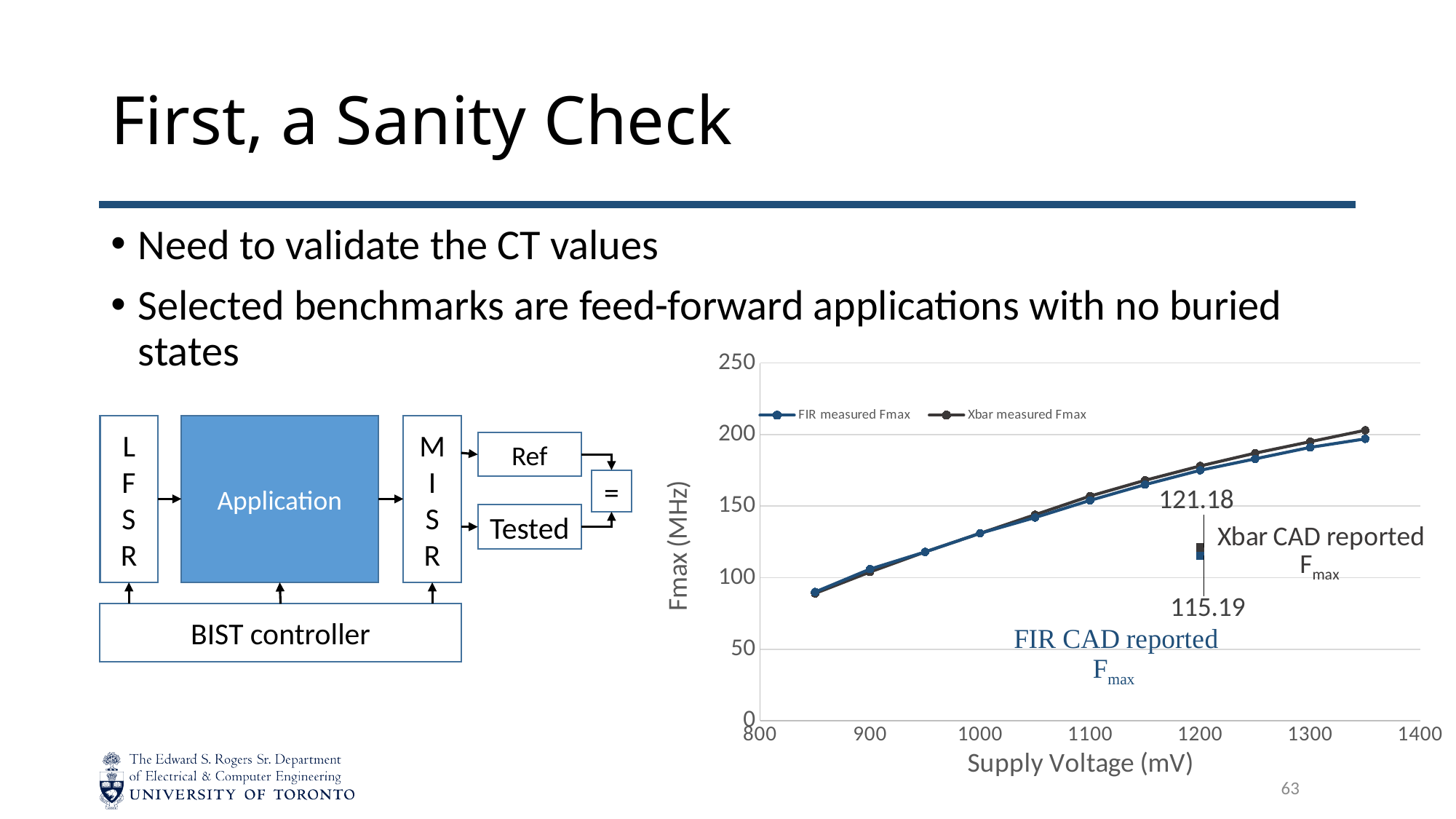
How many series does the chart legend list? 2 What is the difference between the Xbar CAD reported Fmax (121.18) and the FIR CAD reported Fmax (115.19)? 5.99 What is the FIR CAD reported Fmax value labelled on the chart? 115.19 Is the Xbar measured Fmax at 1350 mV greater or less than 150? greater What are the two series named in the chart legend? FIR measured Fmax and Xbar measured Fmax Do the measured Fmax values rise or fall as supply voltage increases? rise Which is larger, the Xbar CAD reported Fmax or the FIR CAD reported Fmax? Xbar CAD reported Fmax Is the FIR measured Fmax at 850 mV greater or less than 100? less What kind of chart is shown on the slide? line chart At which supply voltage is the Xbar measured Fmax highest? 1350 What is the Xbar CAD reported Fmax value labelled on the chart? 121.18 What is the label of the x axis of the chart? Supply Voltage (mV)